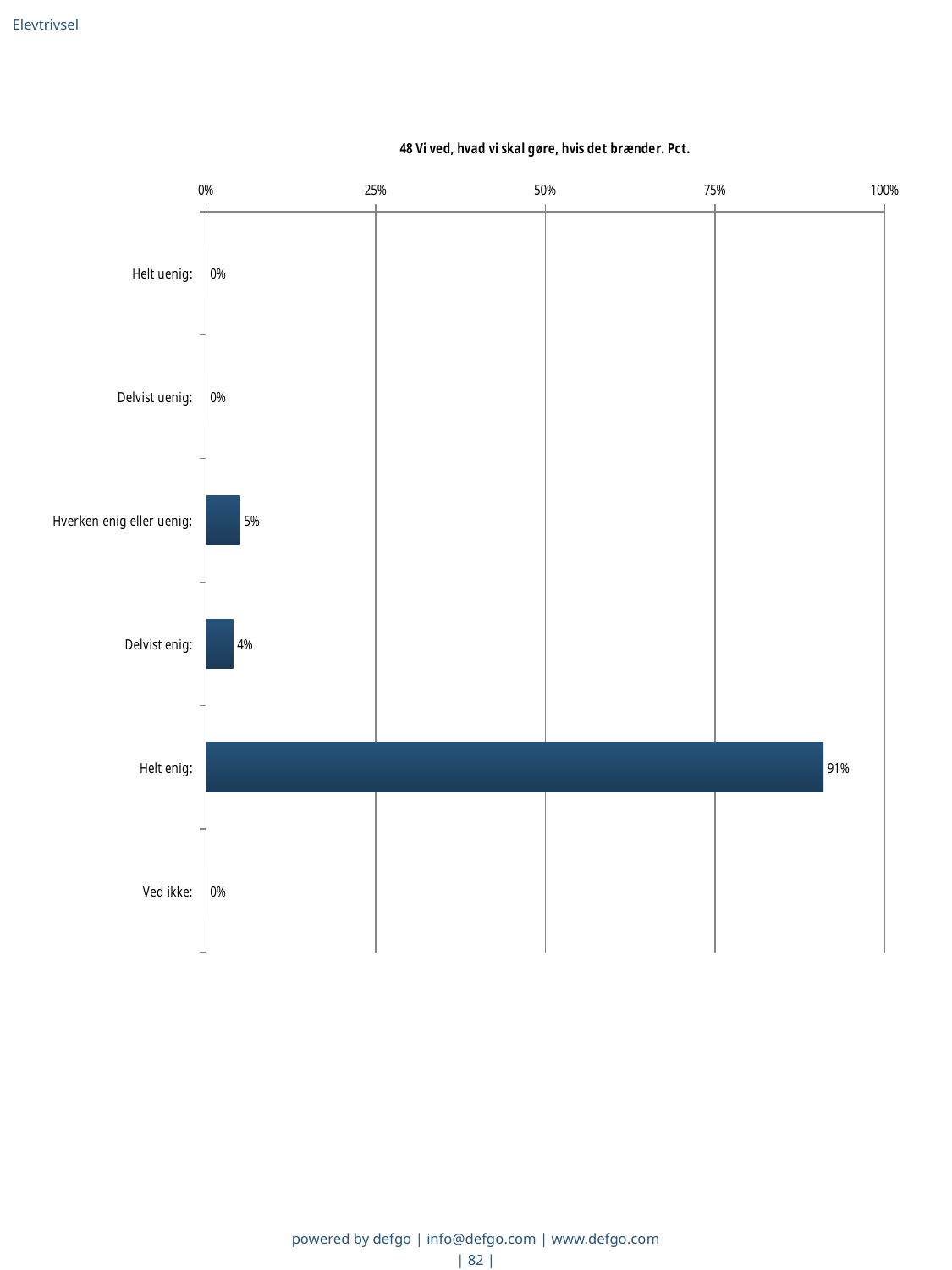
Which is larger, the value for "Helt enig" or the value for "Delvist enig"? Helt enig What is the value for "Helt enig"? 91% What is the value for "Hverken enig eller uenig"? 5% What is the value for "Delvist enig"? 4% Is the value for "Helt enig" greater or less than 75%? greater What is the value for "Ved ikke"? 0% What is the difference between the values for "Hverken enig eller uenig" and "Delvist enig"? 1% What kind of chart is shown on the slide? bar chart What is the title of the chart? 48 Vi ved, hvad vi skal gøre, hvis det brænder. Pct. Which category has the highest value? Helt enig How many categories are shown on the chart? 6 What is the difference between the values for "Helt enig" and "Hverken enig eller uenig"? 86%